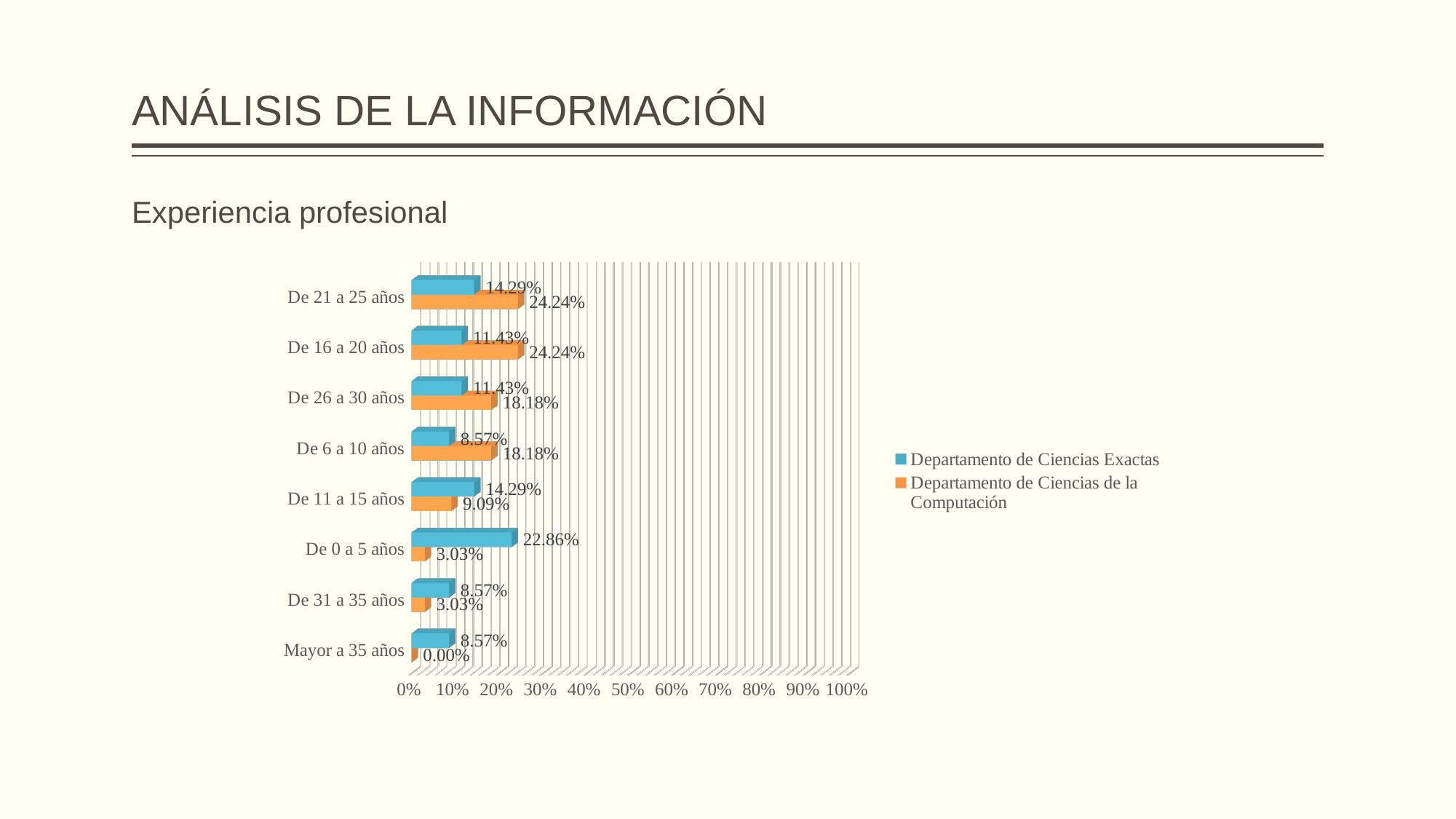
What is the value for Departamento de Ciencias Exactas in the 'De 16 a 20 años' category? 11.43% What is the value for Departamento de Ciencias de la Computación in the 'Mayor a 35 años' category? 0.00% In the 'De 6 a 10 años' category, which series has the larger value? Departamento de Ciencias de la Computación Which category has the lowest value for Departamento de Ciencias de la Computación? Mayor a 35 años Is the value for Departamento de Ciencias de la Computación in 'De 16 a 20 años' greater or less than 20%? greater Which category has the highest value for Departamento de Ciencias Exactas? De 0 a 5 años How many experience categories are shown on the chart? 8 What is the value for Departamento de Ciencias Exactas in the 'De 0 a 5 años' category? 22.86% How many series does the legend list? 2 What is the value for Departamento de Ciencias de la Computación in the 'De 21 a 25 años' category? 24.24% What kind of chart is shown on the slide? Bar chart In the 'De 0 a 5 años' category, what is the difference between the Departamento de Ciencias Exactas value and the Departamento de Ciencias de la Computación value? 19.83 percentage points